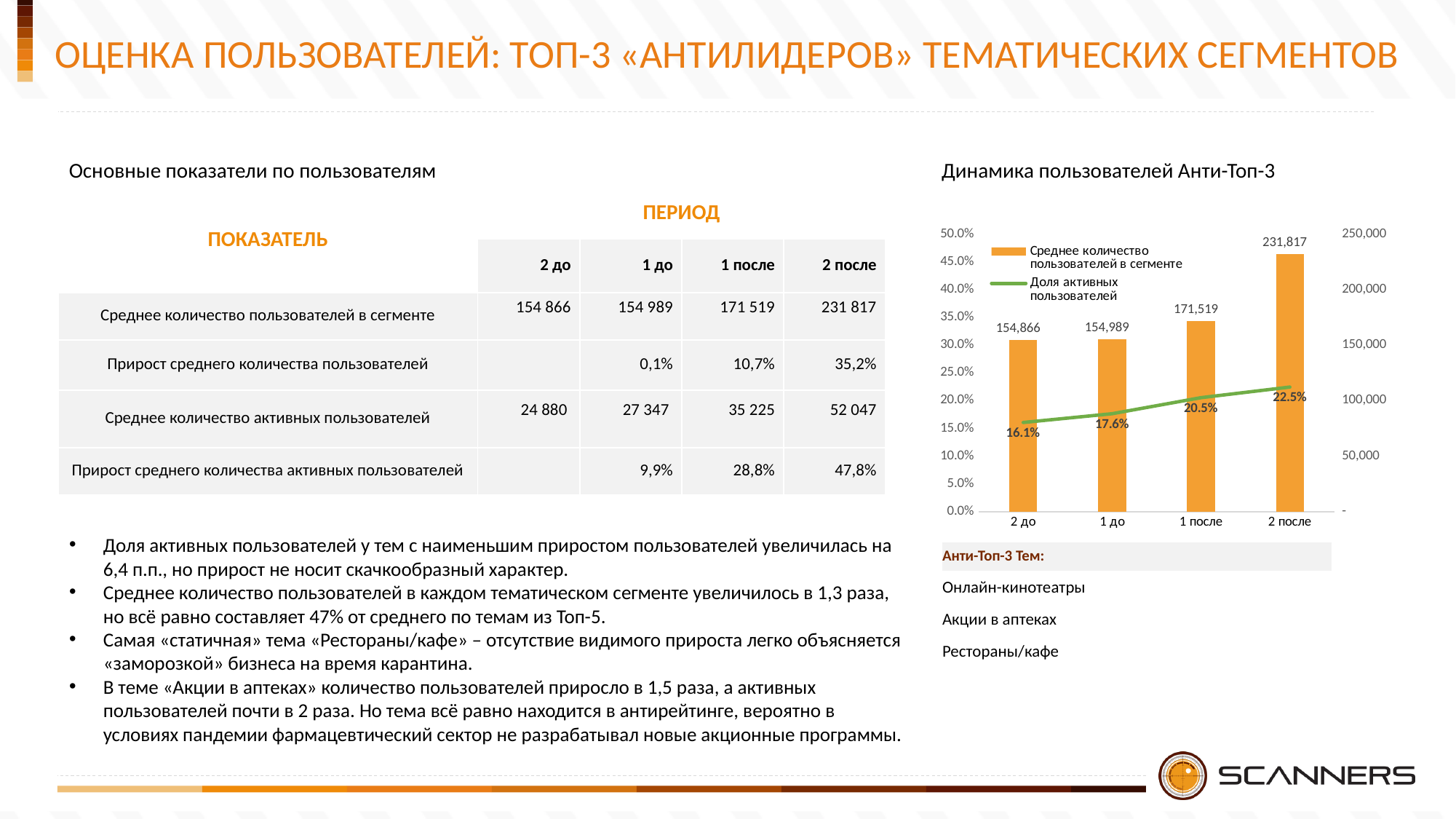
Which period has a larger average number of users: "1 до" or "1 после"? 1 после Which period has the lowest share of active users? 2 до How many series does the chart legend list? 2 Is the share of active users for "1 до" greater or less than 20.0%? less What is the average number of users in the segment for the period "2 после"? 231,817 What is the share of active users for the period "1 после"? 20.5% Which period has the highest average number of users in the segment? 2 после Does the share of active users rise or fall from "2 до" to "2 после"? rise By how many percentage points does the share of active users in "2 после" exceed that in "2 до"? 6.4 What is the share of active users for the period "2 до"? 16.1% What is the difference in average number of users between "2 после" and "1 после"? 60,298 How many periods are shown on the x axis of the chart? 4